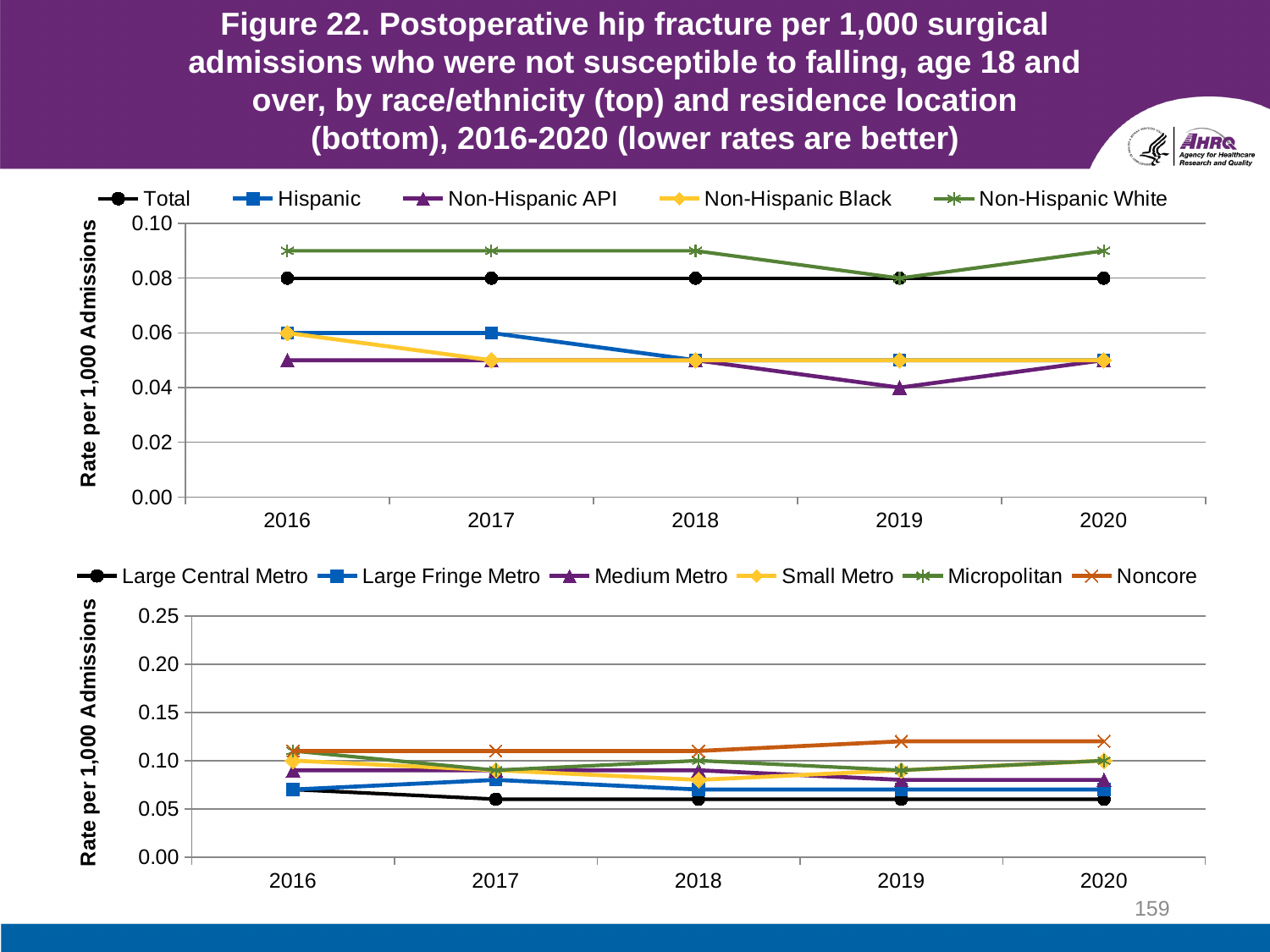
What kind of chart is the top chart (by race/ethnicity)? Line chart In the top chart (by race/ethnicity), is the value for Non-Hispanic White in 2016 greater or less than 0.08? greater In the top chart (by race/ethnicity), what is the rate for Non-Hispanic API in 2019? 0.04 How many series does the legend of the bottom chart (by residence location) list? 6 How many years are shown on the x axis of the top chart (by race/ethnicity)? 5 In the top chart (by race/ethnicity), which group has the highest rate in 2016? Non-Hispanic White In the top chart (by race/ethnicity), does the Hispanic rate rise or fall from 2016 to 2020? Fall In the bottom chart (by residence location), which location has the highest rate in 2020? Noncore In the top chart (by race/ethnicity), what is the rate for Total in 2018? 0.08 In the bottom chart (by residence location), is the value for Noncore in 2019 greater or less than 0.10? greater In the top chart (by race/ethnicity), which group has the lowest rate in 2019? Non-Hispanic API How many series does the legend of the top chart (by race/ethnicity) list? 5